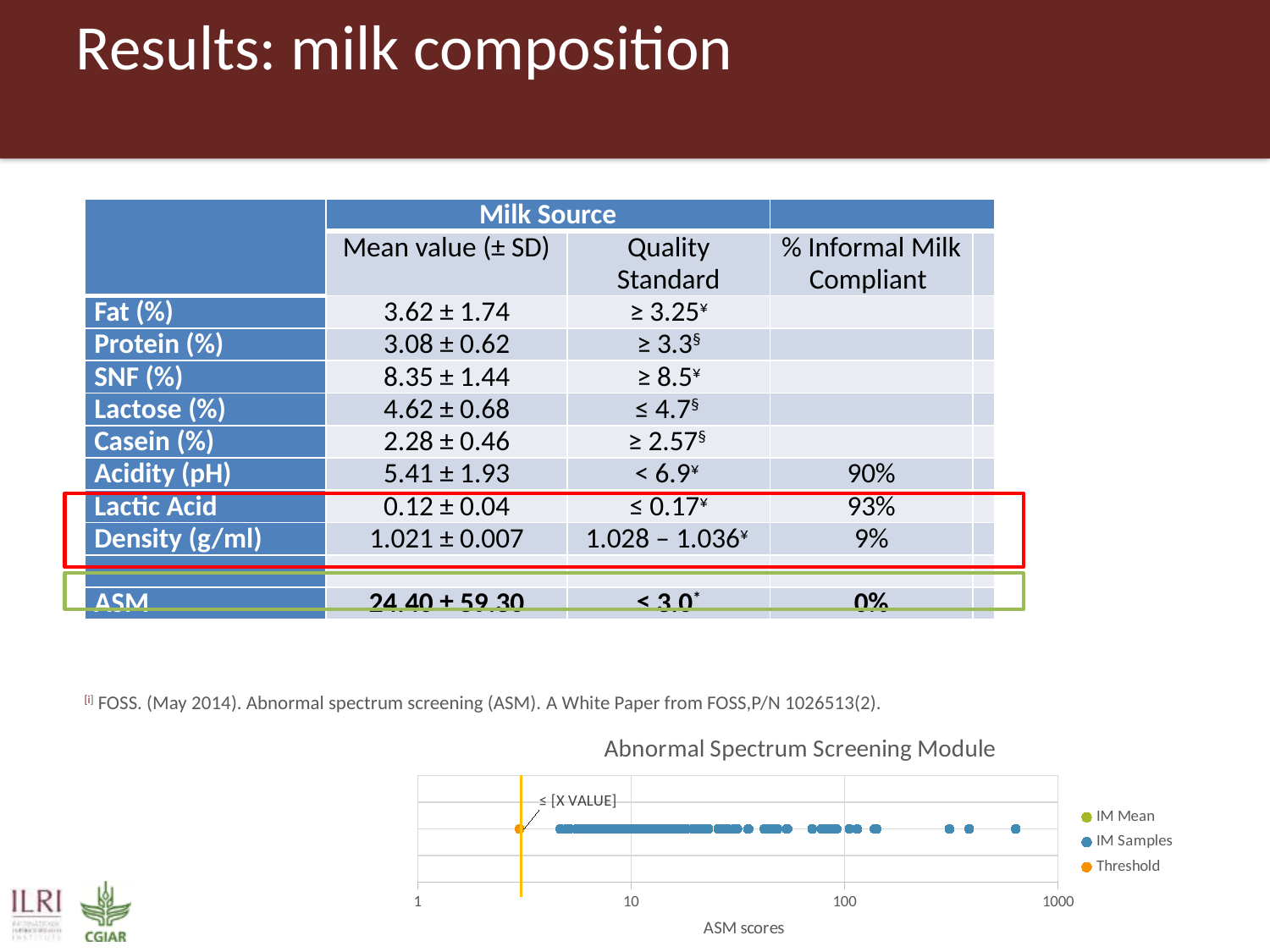
What is the title of the chart at the bottom of the slide? Abnormal Spectrum Screening Module In the Abnormal Spectrum Screening Module chart, which is larger: the Threshold value or the smallest IM Samples value? the smallest IM Samples value In the Abnormal Spectrum Screening Module chart, is the Threshold value greater or less than 10? less How many series does the legend of the Abnormal Spectrum Screening Module chart list? 3 In the Abnormal Spectrum Screening Module chart, is the highest IM Samples value greater or less than 1000? less What is the x-axis title of the Abnormal Spectrum Screening Module chart? ASM scores What kind of chart is the Abnormal Spectrum Screening Module chart? scatter chart In the Abnormal Spectrum Screening Module chart, is the Threshold value greater or less than 1? greater